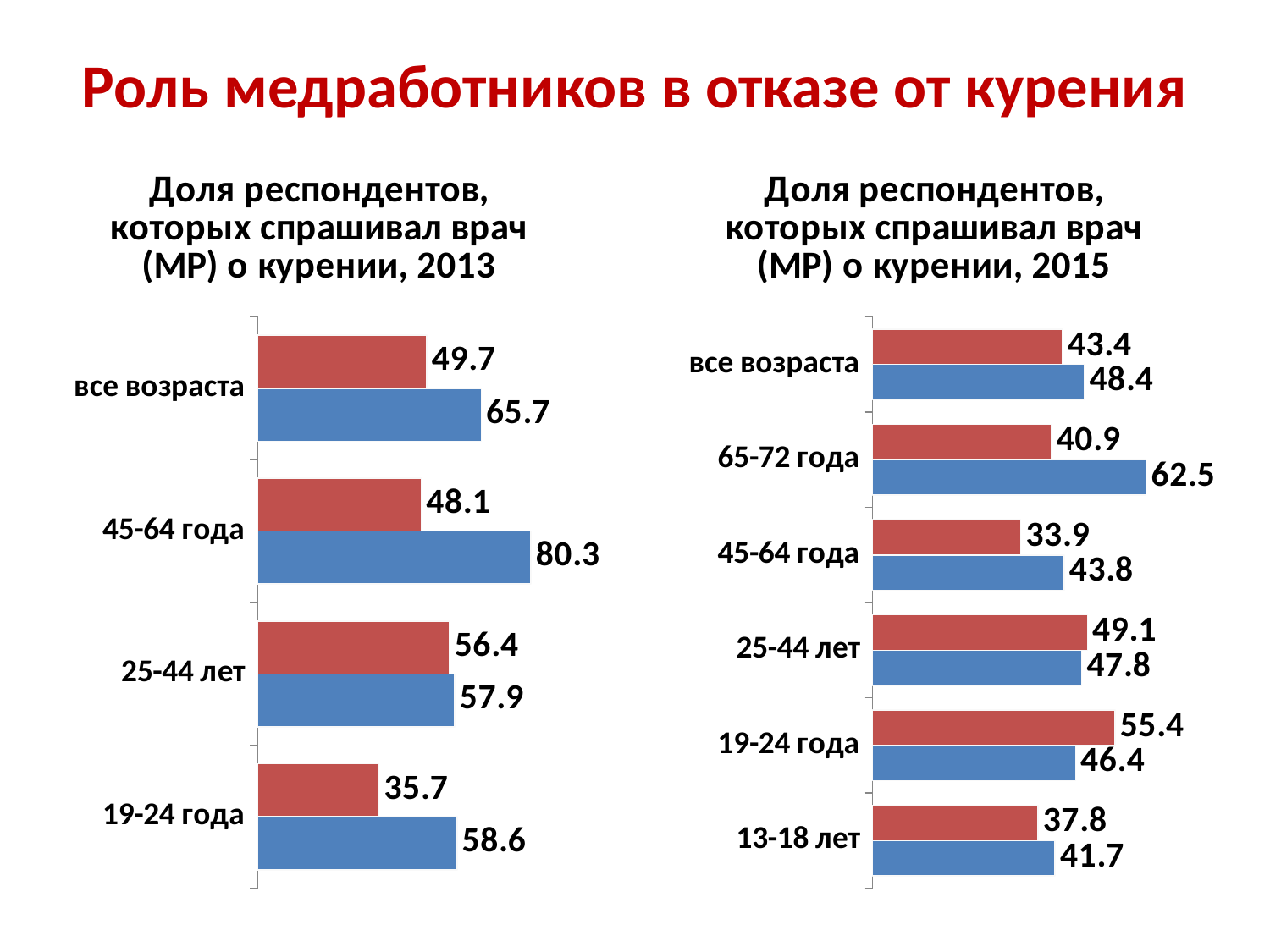
In the 2015 chart (right), what is the difference between the blue and red bar values for 65-72 года? 21.6 In the 2015 chart (right), which age category has the lowest red bar value? 45-64 года In the 2015 chart (right), which is larger for 19-24 года: the red bar or the blue bar? the red bar In the 2015 chart (right), what is the value of the blue bar for 65-72 года? 62.5 How many age categories are shown in the 2013 chart (left)? 4 In the 2013 chart (left), what is the value of the red bar for 19-24 года? 35.7 In the 2013 chart (left), which age category has the highest blue bar value? 45-64 года In the 2013 chart (left), what is the difference between the blue and red bar values for 19-24 года? 22.9 In the 2013 chart (left), what is the value of the blue bar for 45-64 года? 80.3 In the 2015 chart (right), what is the value of the red bar for 45-64 года? 33.9 What type of chart is used on the left side of the slide? bar chart How many age categories are shown in the 2015 chart (right)? 6